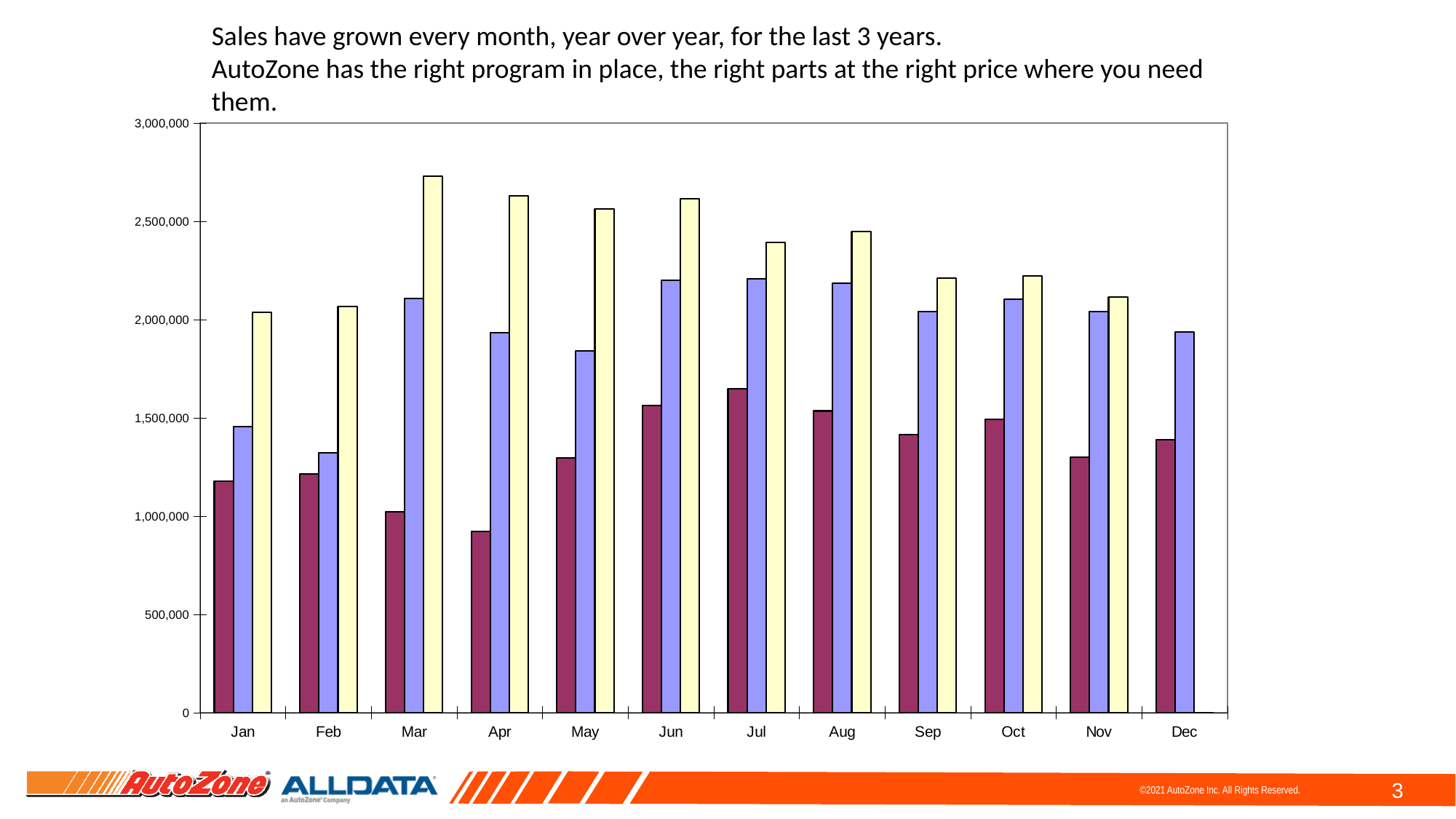
Is the pale yellow (third) bar for Mar greater or less than 2,500,000? greater In which month is the maroon (first) bar the tallest? Jul In which month is the pale yellow (third) bar the tallest? Mar Is the light blue (second) bar for Jun greater or less than 2,000,000? greater In which month is the light blue (second) bar the shortest? Feb How many bars are plotted for Jan in the chart? 3 How many months are shown along the x axis of the chart? 12 In which month is the maroon (first) bar the shortest? Apr Is the maroon (first) bar for Apr greater or less than 1,000,000? less What kind of chart is shown on the slide? bar chart Which is taller: the light blue (second) bar for Nov or the light blue (second) bar for Dec? Nov Which month has only two bars instead of three? Dec